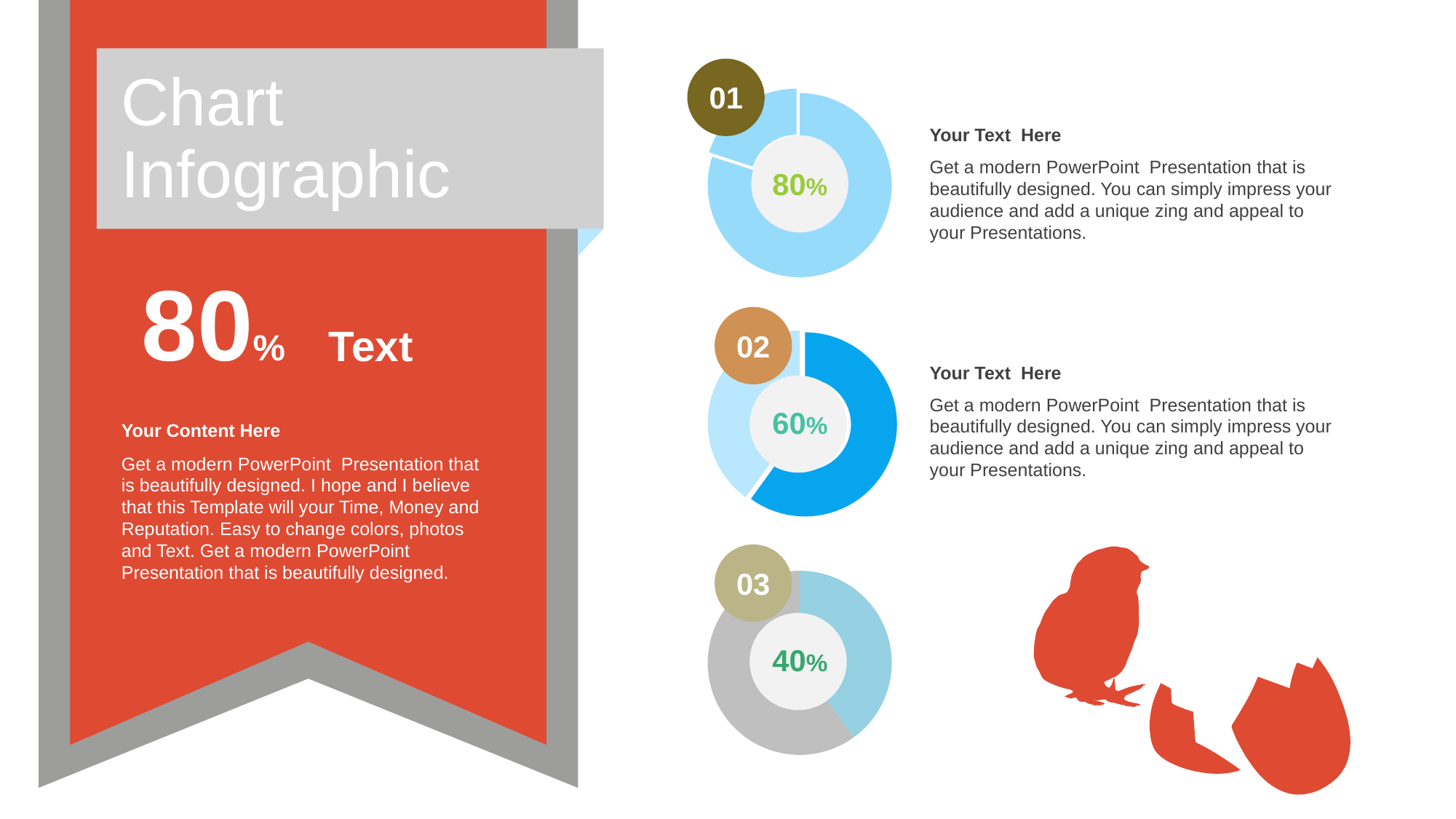
What is the difference between the percentage in chart 01 and the percentage in chart 02? 20% What value is shown in the centre of the donut chart labelled 03? 40% Do the percentages in the donut charts increase or decrease going from chart 01 down to chart 03? Decrease Which of the three numbered donut charts shows the highest percentage? 01 What kind of chart is used for the three numbered items on the right of the slide? Donut (pie) chart Which of the three numbered donut charts shows the lowest percentage? 03 How many donut charts are shown on the slide? 3 What value is shown in the centre of the donut chart labelled 01? 80% What value is shown in the centre of the donut chart labelled 02? 60% What is the difference between the percentage in chart 02 and the percentage in chart 03? 20% What is the title shown in the grey banner on the left of the slide? Chart Infographic Which shows a larger percentage, the donut chart labelled 02 or the one labelled 03? 02